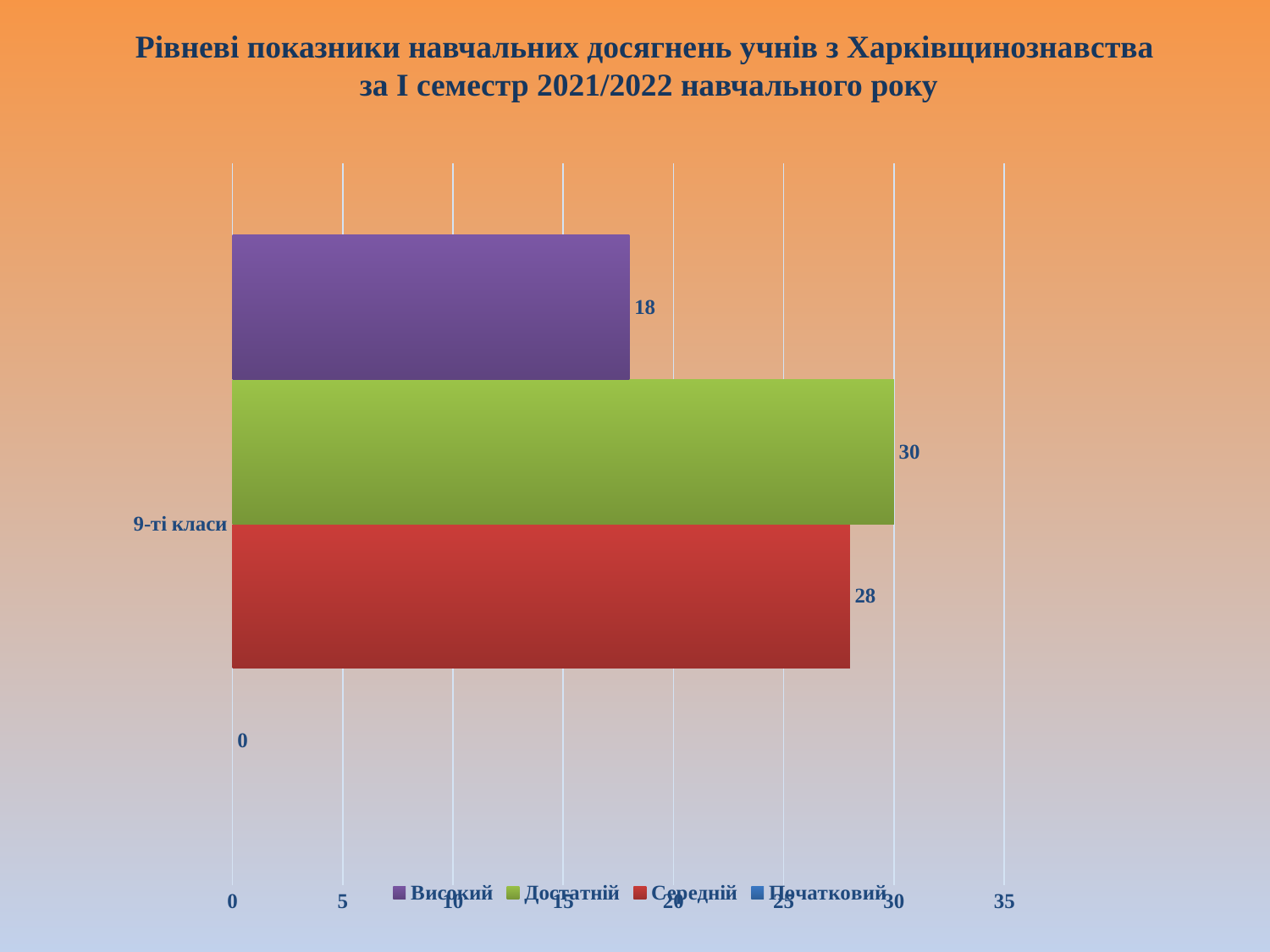
What is the value for Початковий for 9-ті класи? 0 What is the value for Високий for 9-ті класи? 18 What colour is the bar for Достатній? green What is the value for Достатній for 9-ті класи? 30 What type of chart is shown on the slide? bar chart How many categories are shown on the vertical axis? 1 Which series has the highest value for 9-ті класи? Достатній What is the value for Середній for 9-ті класи? 28 Which is larger for 9-ті класи, Середній or Високий? Середній Which series has the lowest value for 9-ті класи? Початковий How many series does the legend list? 4 What is the difference between the Достатній and Високий values for 9-ті класи? 12